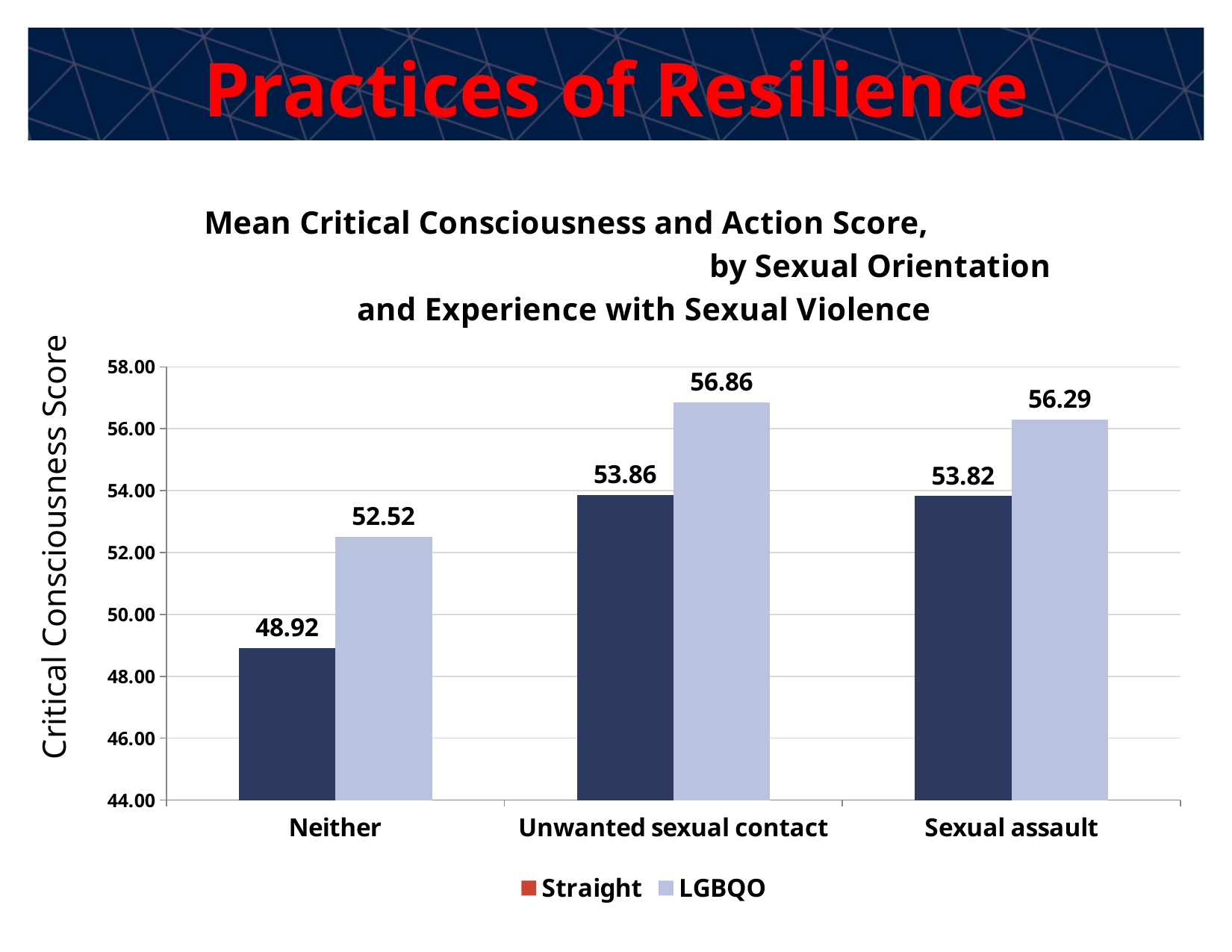
What is the mean Critical Consciousness score for LGBQO respondents in the Sexual assault category? 56.29 How many categories are shown on the x axis? 3 What is the mean Critical Consciousness score for Straight respondents in the Neither category? 48.92 What is the mean Critical Consciousness score for LGBQO respondents in the Unwanted sexual contact category? 56.86 What kind of chart is shown on the slide? Bar chart Which is larger: the Straight score for Sexual assault or the LGBQO score for Neither? Straight score for Sexual assault What is the difference between the LGBQO and Straight scores in the Neither category? 3.60 Is the Straight score for Neither greater or less than 50.00? less Which category has the highest LGBQO score? Unwanted sexual contact Which category has the lowest Straight score? Neither What is the difference between the LGBQO and Straight scores in the Unwanted sexual contact category? 3.00 How many series does the legend list? 2